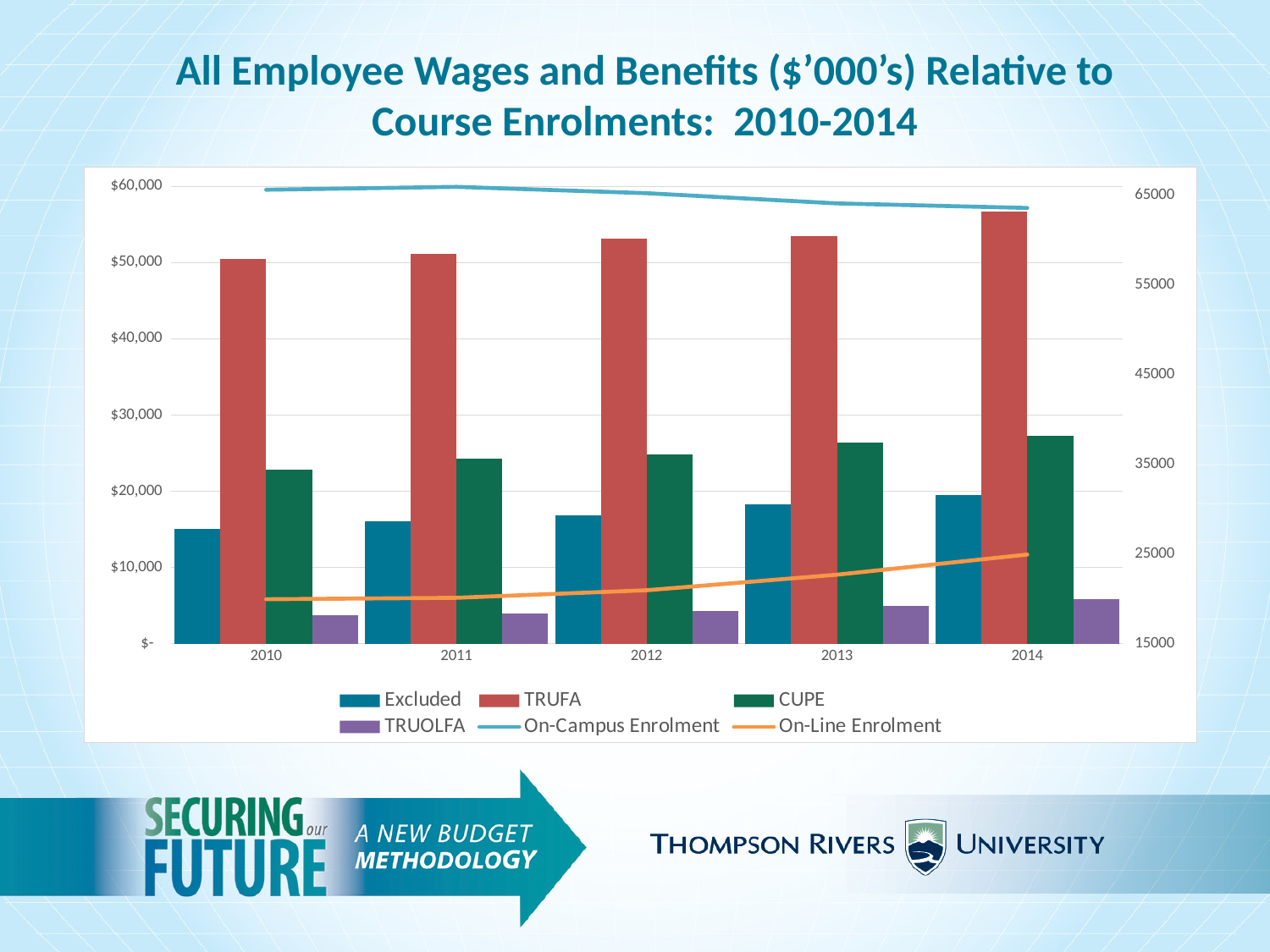
How many series does the legend list? 6 What kind of chart is shown on the slide? A combined bar and line chart How many years are shown along the x axis? 5 Which employee group has the shortest bar in 2010? TRUOLFA What is the title of the chart? All Employee Wages and Benefits ($'000's) Relative to Course Enrolments: 2010-2014 Does the On-Line Enrolment line rise or fall from 2010 to 2014? rise In 2013, which is larger: the CUPE bar or the Excluded bar? CUPE Is the Excluded value for 2010 greater or less than $20,000? less Does the On-Campus Enrolment line rise or fall from 2010 to 2014? fall Is the CUPE value for 2014 greater or less than $20,000? greater Which employee group has the tallest bar in 2014? TRUFA Is the TRUFA value for 2014 greater or less than $50,000? greater